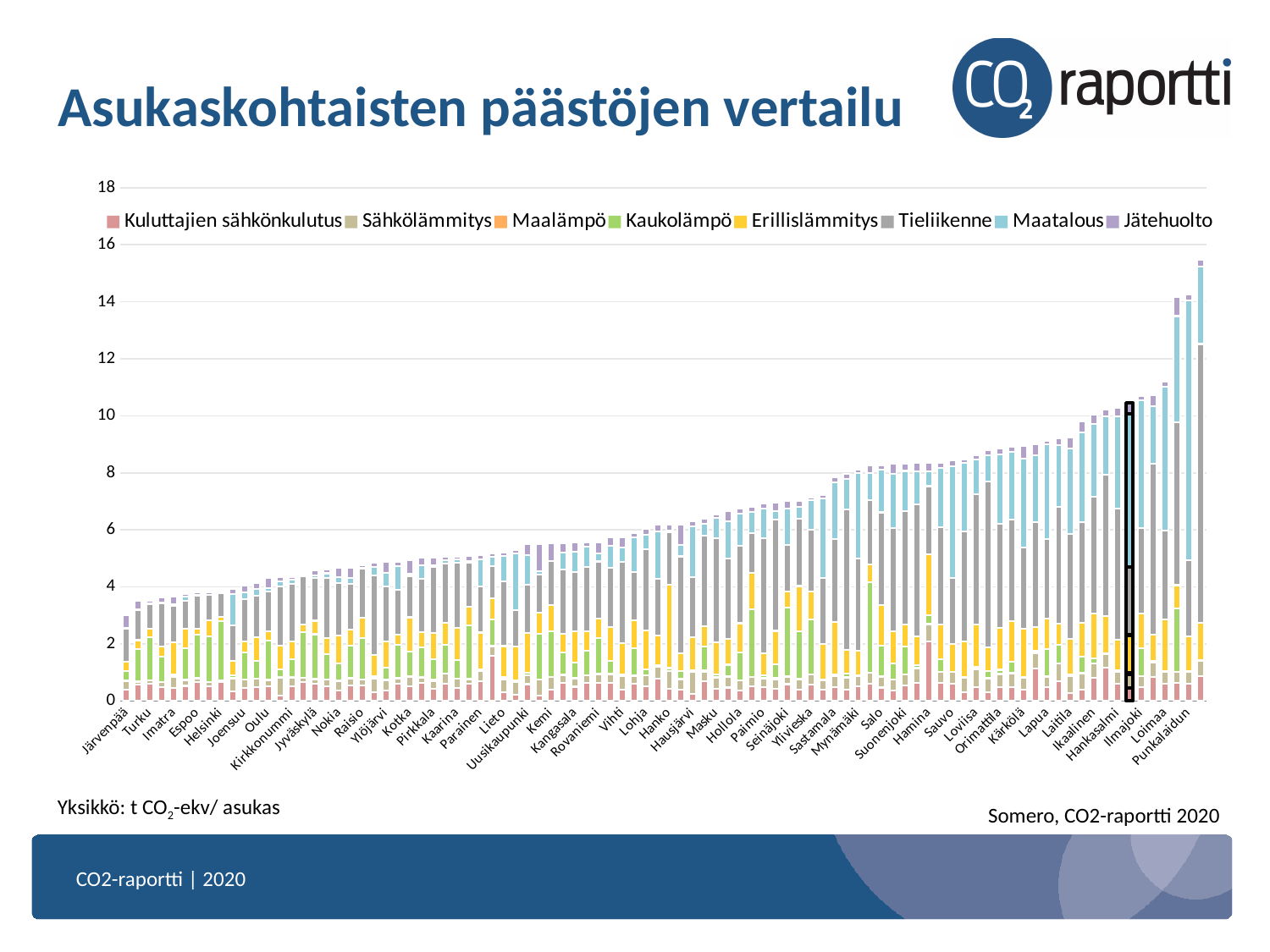
What kind of chart is shown on the slide? Stacked bar chart Which municipality has the lowest total emissions per inhabitant in the chart? Järvenpää Which has the larger total, Turku or Loimaa? Loimaa Is the total value for Helsinki greater or less than 6? less Is the total value for Järvenpää greater or less than 4? less How many series does the legend list? 8 Is the total value for Loimaa greater or less than 12? less What is the title of the chart on the slide? Asukaskohtaisten päästöjen vertailu What unit is stated for the values in the chart? t CO2-ekv/ asukas Do the total bar heights rise or fall from left to right along the x axis? Rise